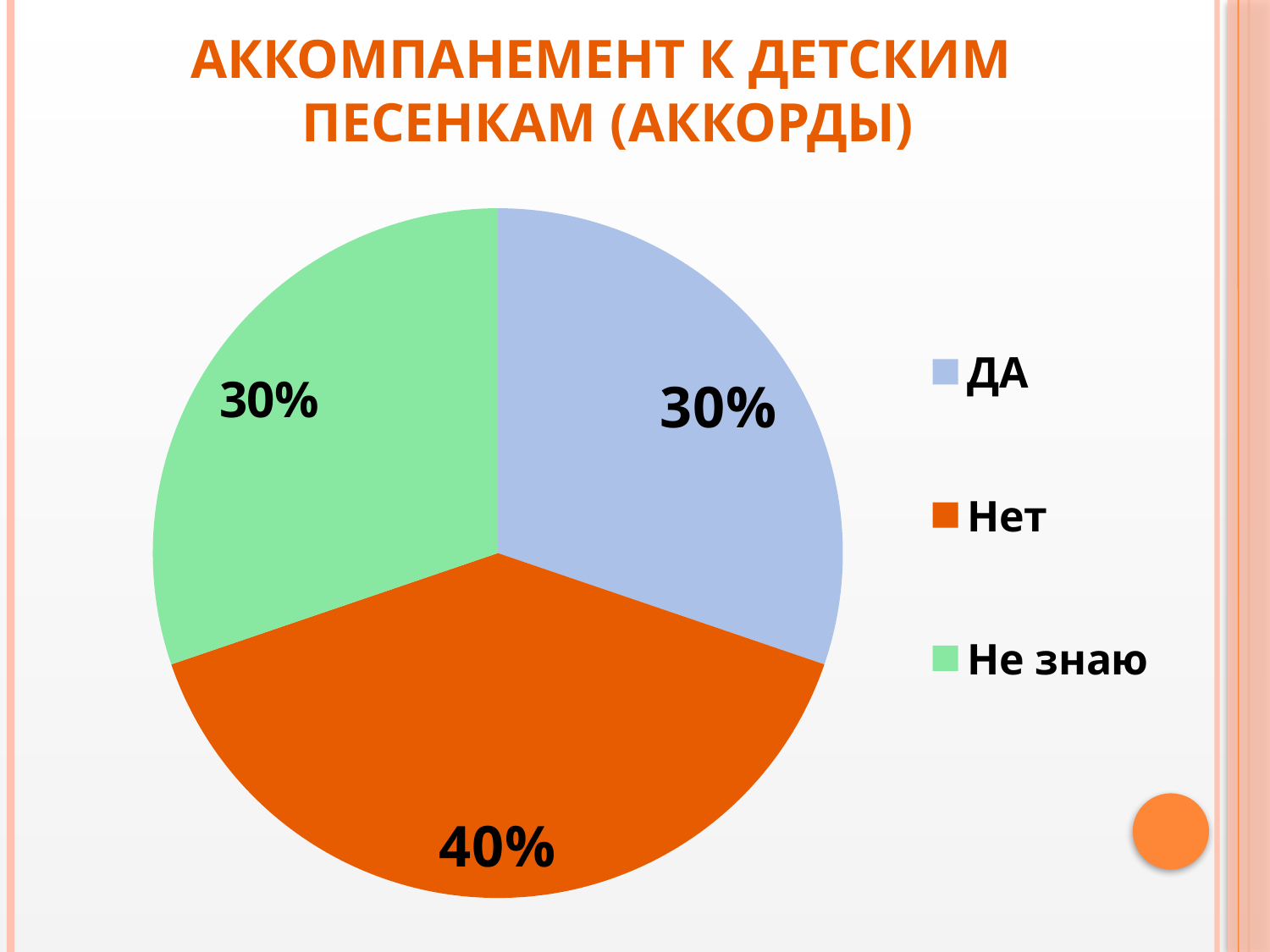
What colour is the "Нет" slice in the pie chart? orange Which is larger, the "Нет" slice or the "Не знаю" slice? Нет How many slices does the pie chart have? 3 What kind of chart is shown on the slide? pie chart What share of the pie does the "Не знаю" slice represent? 30% What share of the pie does the "ДА" slice represent? 30% What is the difference between the "Нет" share and the "ДА" share? 10% What is the title of the chart on the slide? АККОМПАНЕМЕНТ К ДЕТСКИМ ПЕСЕНКАМ (АККОРДЫ) What share of the pie does the "Нет" slice represent? 40% How many entries does the legend list? 3 Which category has the largest slice of the pie? Нет